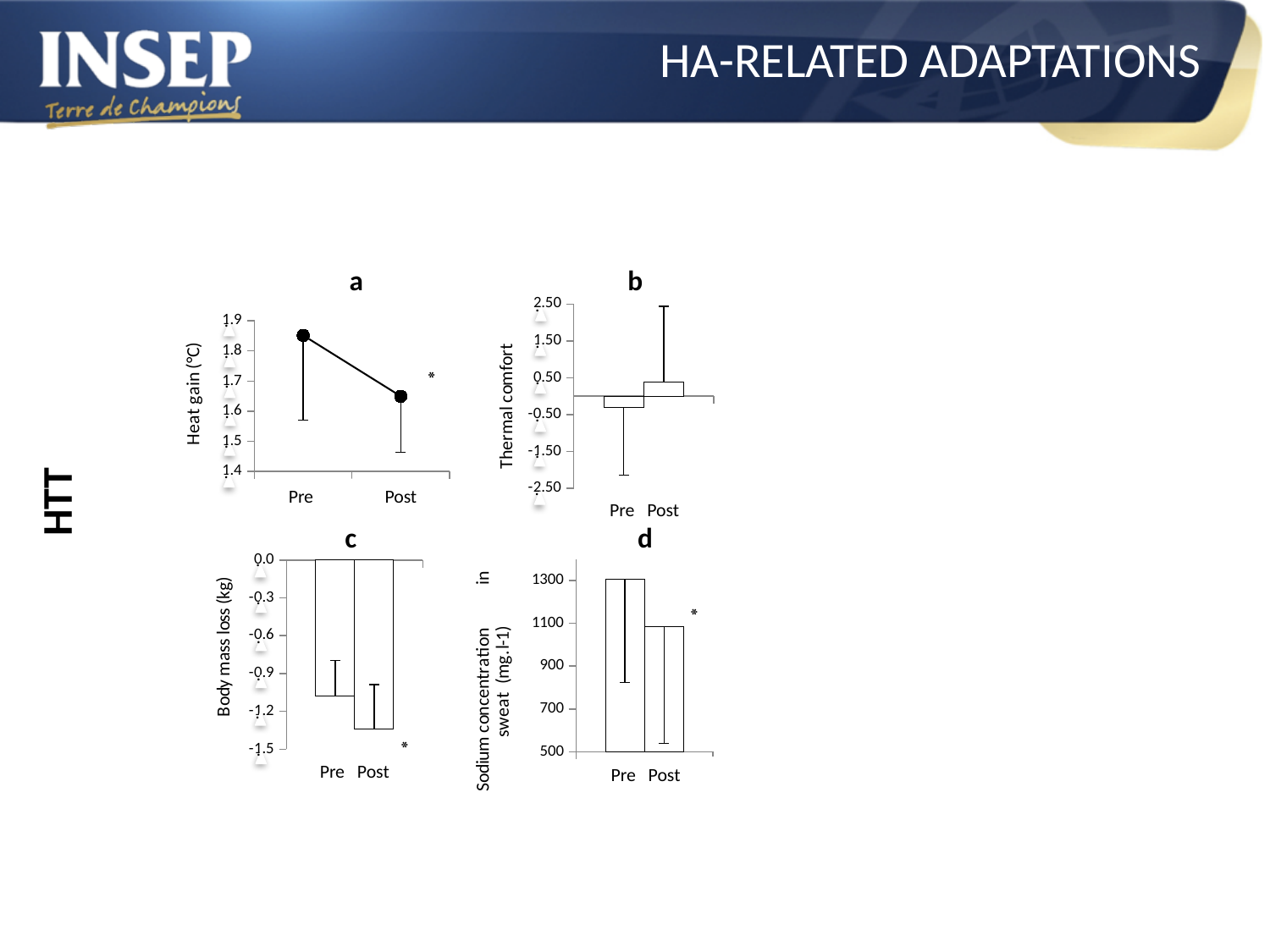
What kind of chart is chart b (Thermal comfort)? bar chart In chart b (Thermal comfort), which is larger, Pre or Post? Post How many categories are shown on the x axis of chart d (Sodium concentration in sweat)? 2 In chart c (Body mass loss), is the value for Post greater or less than -1.2? less In chart a (Heat gain), is the value for Post greater or less than 1.7? less In chart a (Heat gain), does the value rise or fall from Pre to Post? fall In chart d (Sodium concentration in sweat), is the value for Pre greater or less than 1100? greater In chart d (Sodium concentration in sweat), which is larger, Pre or Post? Pre What kind of chart is chart a (Heat gain)? line chart In chart c (Body mass loss), which category has the lowest value? Post